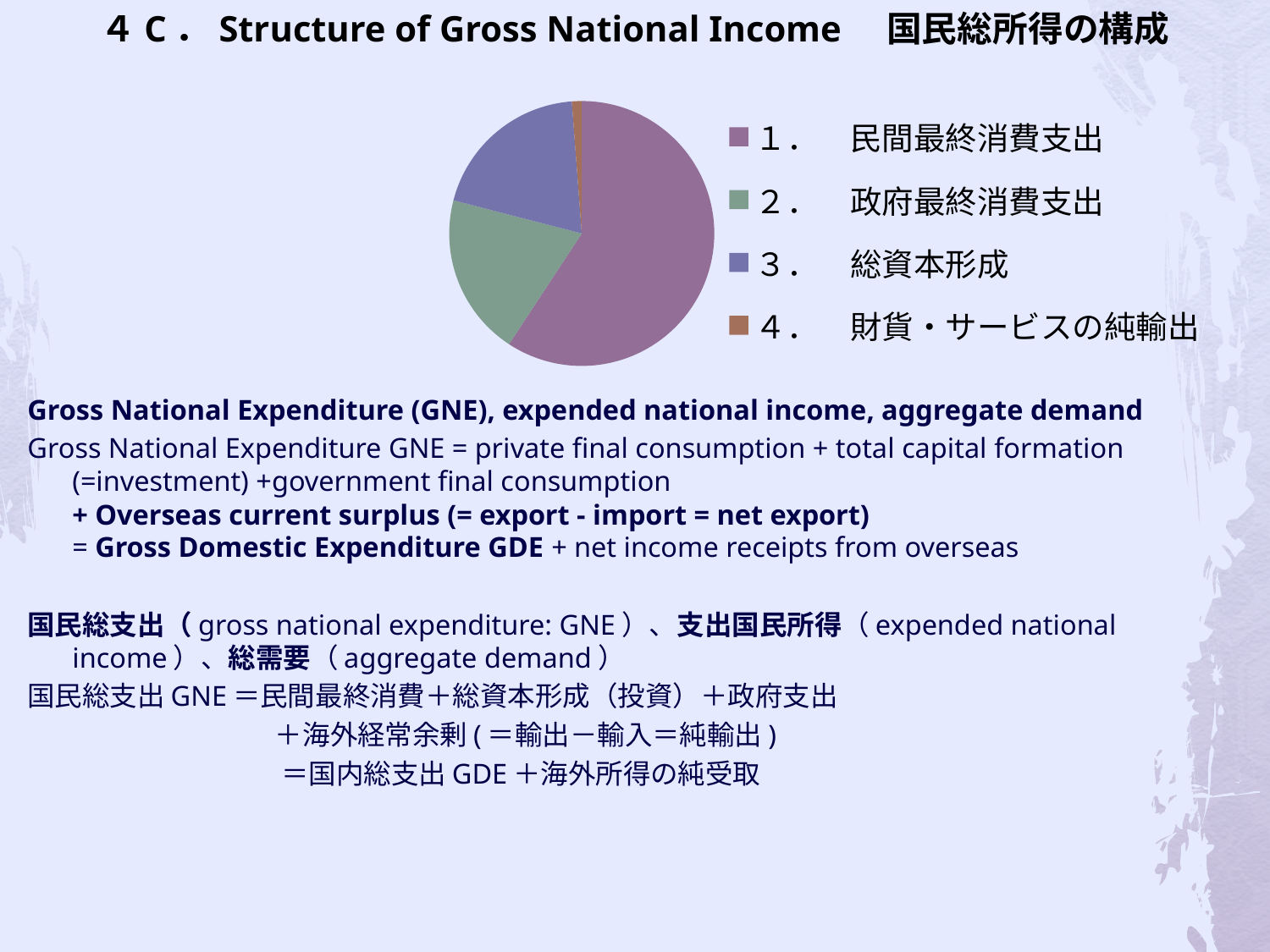
How many slices does the pie chart have? 4 Which slice is larger, 1. 民間最終消費支出 or 2. 政府最終消費支出? 1. 民間最終消費支出 Is the share of 1. 民間最終消費支出 greater or less than half of the pie? greater What colour is the slice for 1. 民間最終消費支出 in the pie chart? purple What is the label of the fourth legend entry in the pie chart? 4. 財貨・サービスの純輸出 Which slice is larger, 1. 民間最終消費支出 or 3. 総資本形成? 1. 民間最終消費支出 Which category has the smallest slice of the pie chart? 4. 財貨・サービスの純輸出 How many entries does the legend of the pie chart list? 4 Which category has the largest slice of the pie chart? 1. 民間最終消費支出 Which slice is larger, 2. 政府最終消費支出 or 4. 財貨・サービスの純輸出? 2. 政府最終消費支出 What kind of chart is shown on the slide? pie chart